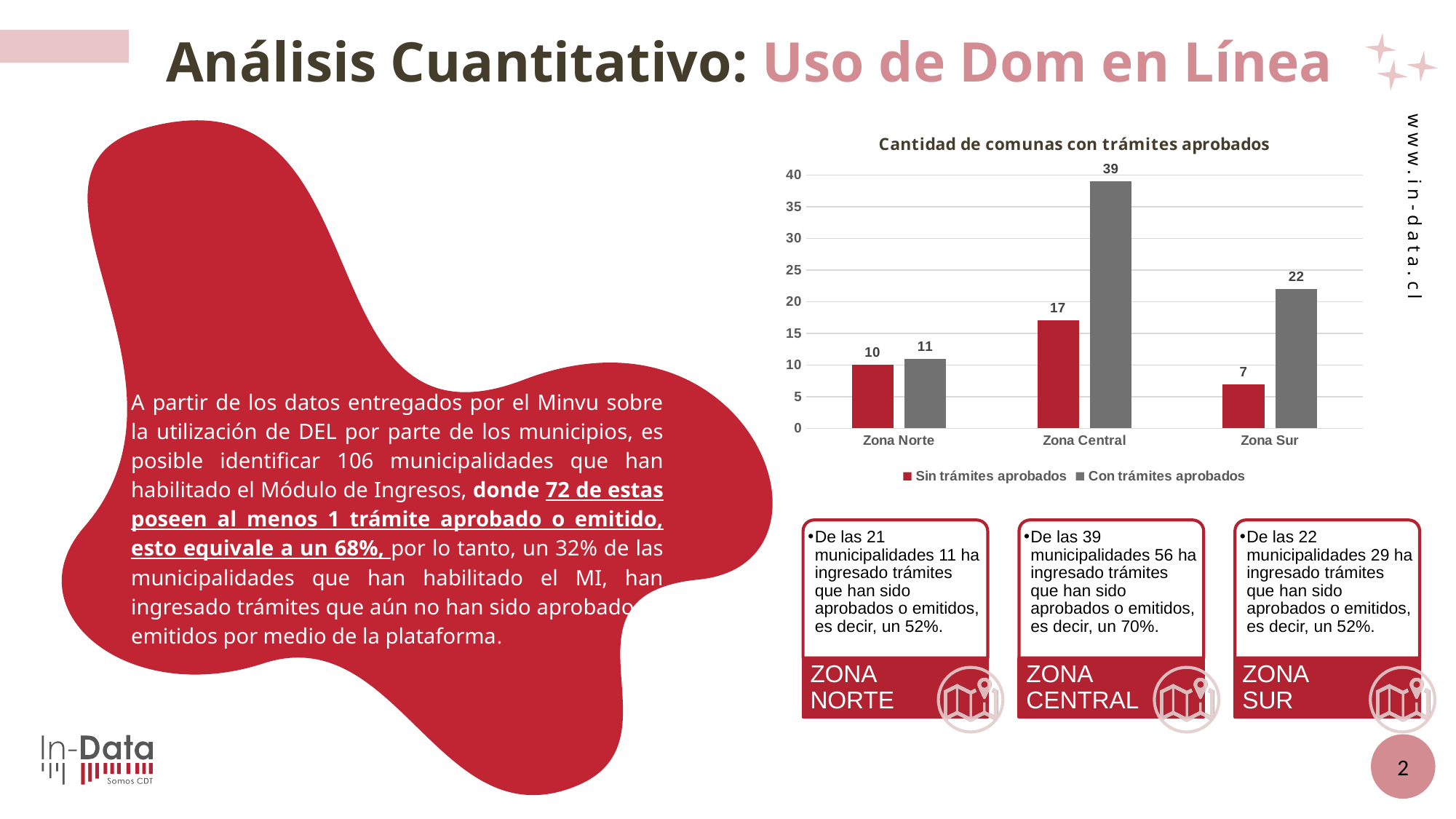
What is the difference between 'Con trámites aprobados' and 'Sin trámites aprobados' in Zona Central? 22 Which is larger in Zona Sur: 'Sin trámites aprobados' or 'Con trámites aprobados'? Con trámites aprobados What is the value for 'Sin trámites aprobados' in Zona Sur? 7 Is the value for 'Con trámites aprobados' in Zona Sur greater or less than 20? greater How many series does the chart legend list? 2 Which zone has the lowest value for 'Sin trámites aprobados'? Zona Sur What is the value for 'Con trámites aprobados' in Zona Central? 39 How many zones are shown on the x axis of the chart? 3 What kind of chart is shown on the slide? Bar chart What is the value for 'Sin trámites aprobados' in Zona Norte? 10 What is the title of the chart? Cantidad de comunas con trámites aprobados Which zone has the highest value for 'Con trámites aprobados'? Zona Central